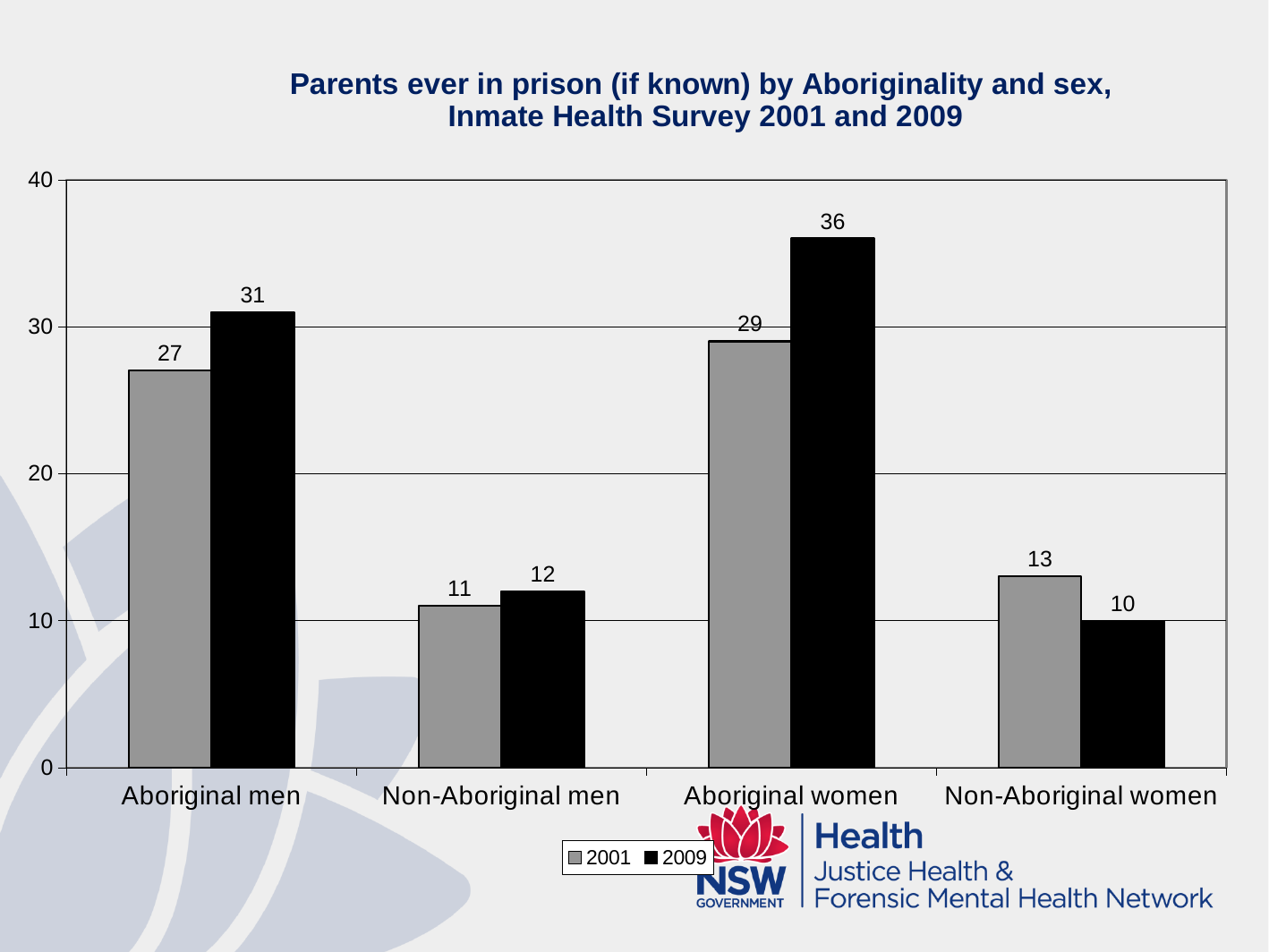
What is the 2001 value for Aboriginal men? 27 What is the difference between the 2009 and 2001 values for Aboriginal women? 7 Which category has the lowest 2001 value? Non-Aboriginal men What kind of chart is shown on the slide? Bar chart What is the 2009 value for Aboriginal women? 36 How many categories are shown on the x axis? 4 What is the 2009 value for Non-Aboriginal women? 10 How many series does the legend list? 2 Which is larger for Non-Aboriginal women, the 2001 value or the 2009 value? 2001 Which series is shown in black in the legend? 2009 What is the 2001 value for Non-Aboriginal men? 11 Which category has the highest 2009 value? Aboriginal women